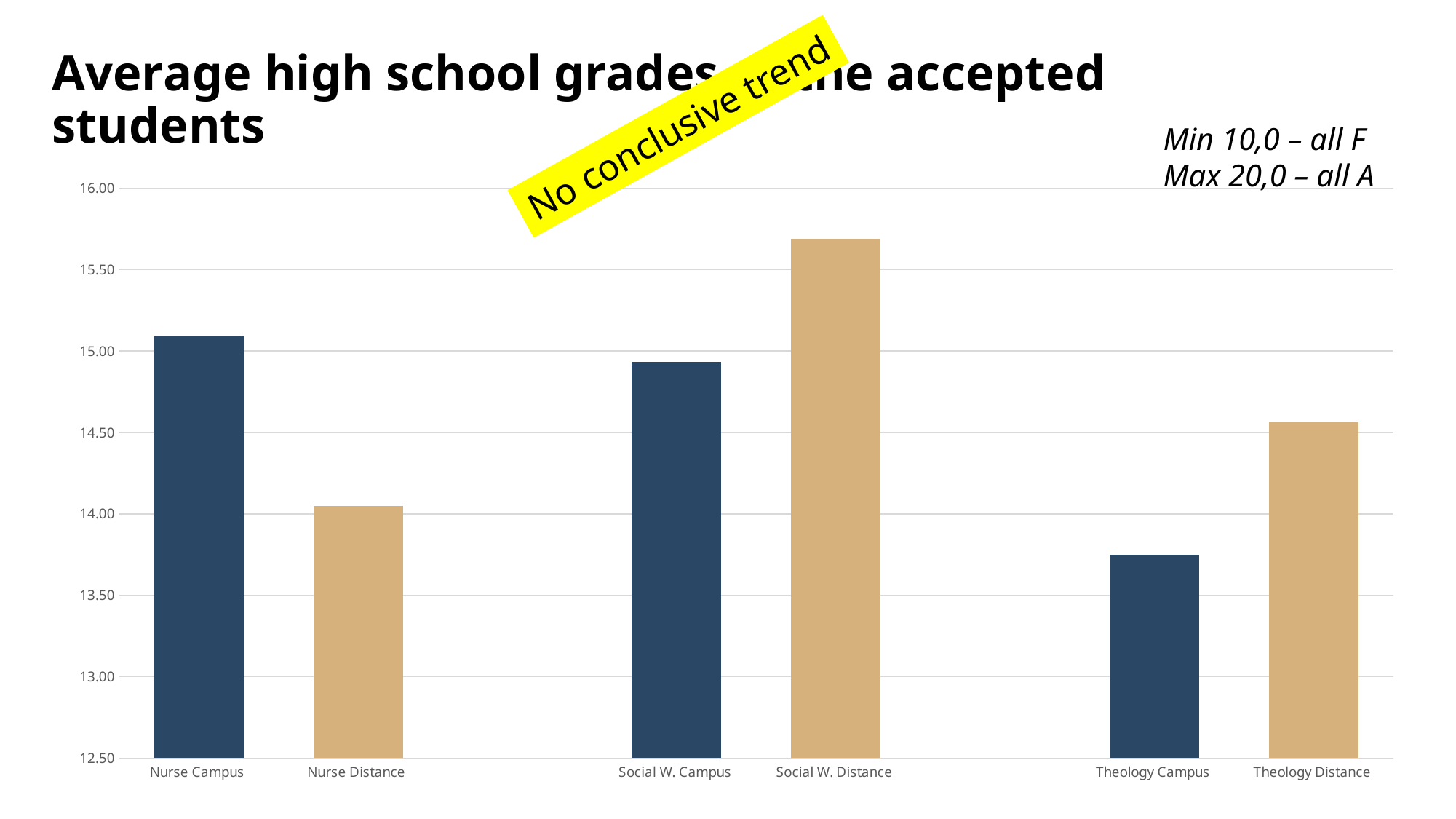
Which category has the lowest average high school grade? Theology Campus Is the value for Social W. Distance greater or less than 15.50? greater Which is larger, the value for Social W. Distance or the value for Social W. Campus? Social W. Distance Which category has the highest average high school grade? Social W. Distance Which is larger, the value for Theology Distance or the value for Theology Campus? Theology Distance How many categories (bars) are plotted in the chart? 6 What does the yellow sticker placed over the chart title say? No conclusive trend What kind of chart is shown on the slide? bar chart Which is larger, the value for Nurse Campus or the value for Nurse Distance? Nurse Campus Is the value for Theology Campus greater or less than 14.00? less Is the value for Nurse Campus greater or less than 15.00? greater